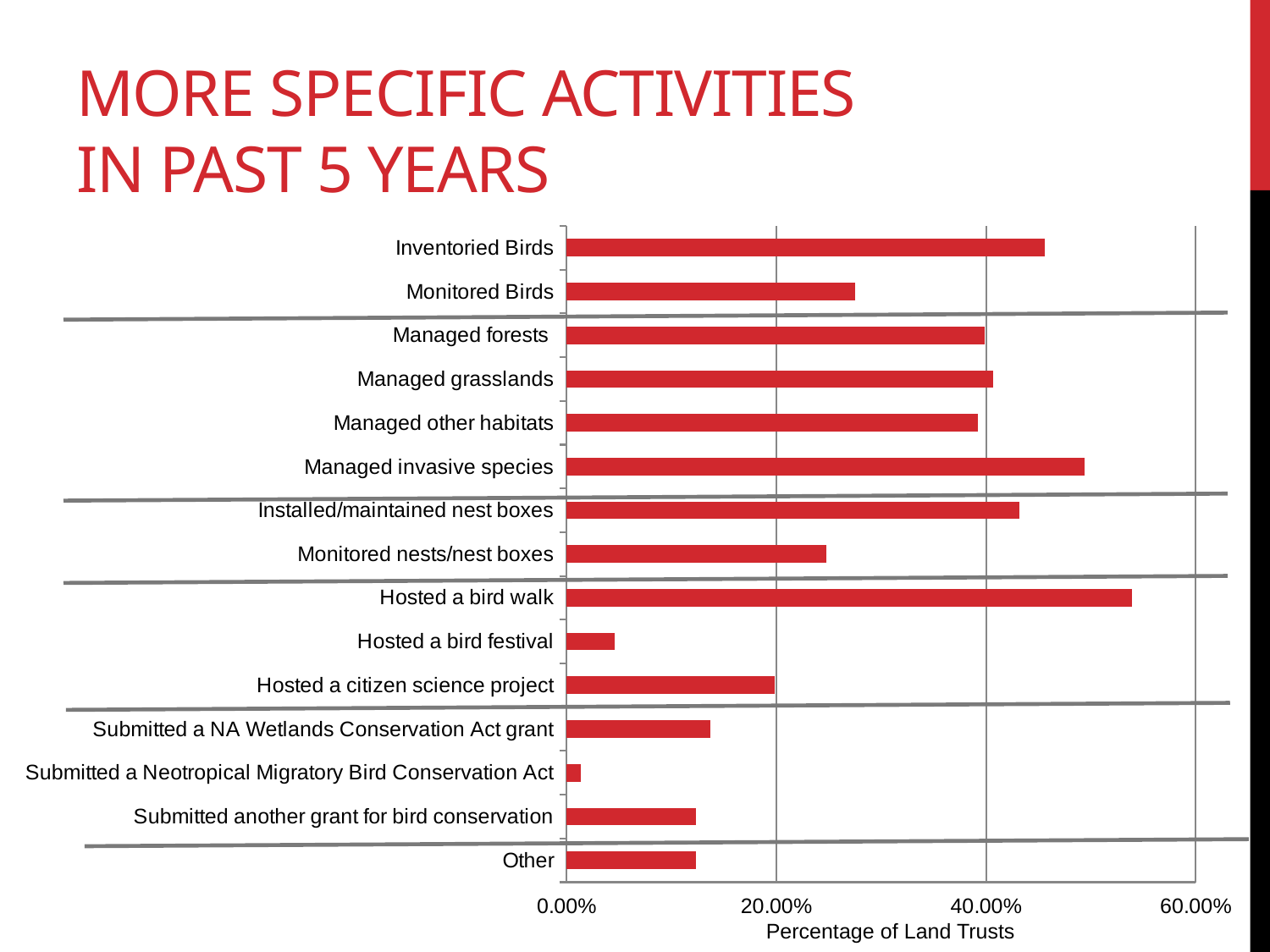
Which is larger, the value for Hosted a bird walk or the value for Inventoried Birds? Hosted a bird walk Is the value for Managed invasive species greater or less than 40.00%? greater Is the value for Monitored Birds greater or less than 20.00%? greater Which activity has the lowest percentage of land trusts? Submitted a Neotropical Migratory Bird Conservation Act Is the value for Submitted a NA Wetlands Conservation Act grant greater or less than 20.00%? less What kind of chart is shown on the slide? bar chart What is the title of the horizontal axis? Percentage of Land Trusts Which activity has the highest percentage of land trusts? Hosted a bird walk Which is larger, the value for Managed invasive species or the value for Managed forests? Managed invasive species How many activities (categories) are plotted in the chart? 15